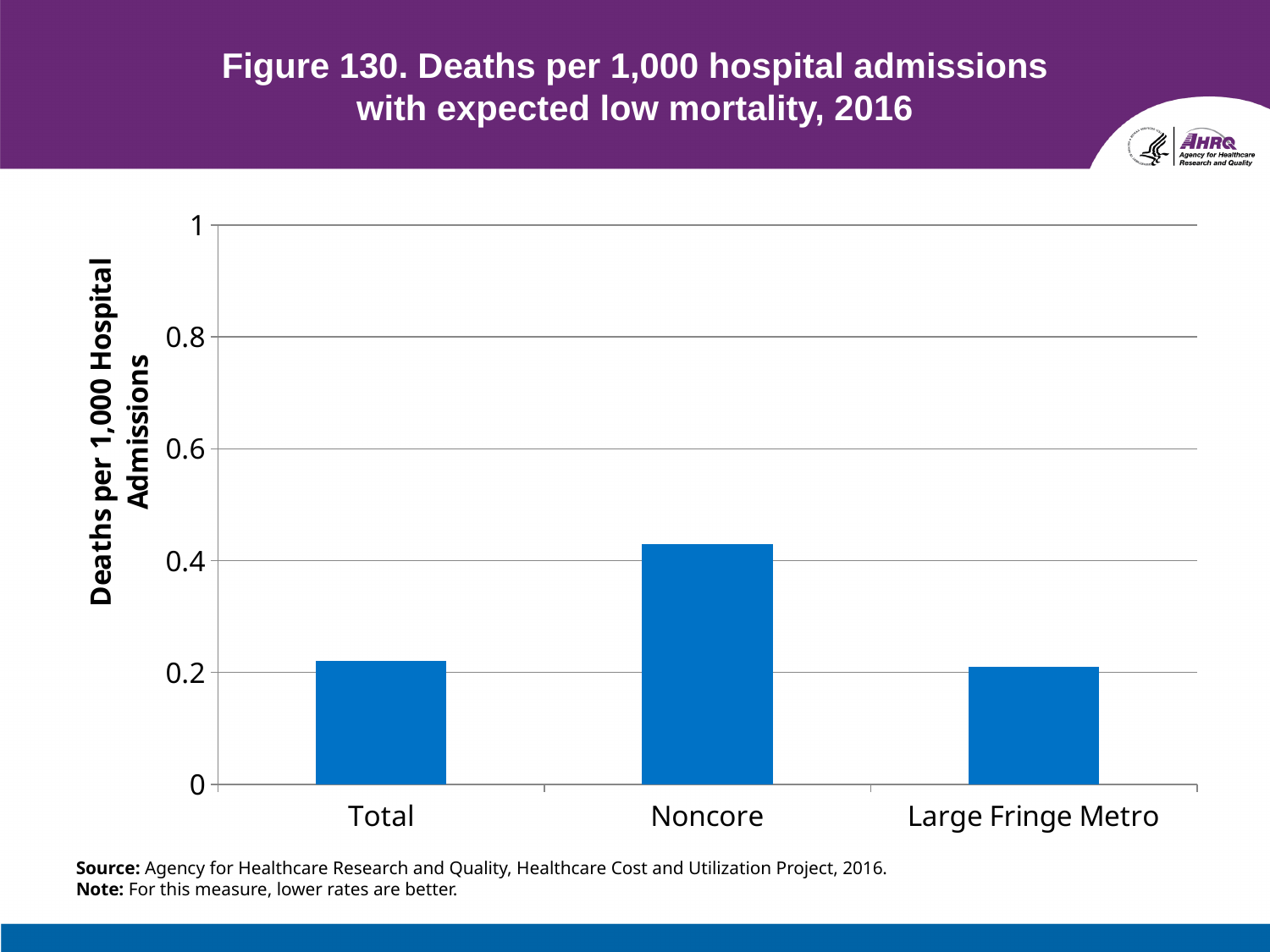
Is the value for Total greater or less than 0.4? less What is the highest value shown on the y axis of the chart? 1 Is the value for Noncore greater or less than 0.4? greater Which is larger, the value for Large Fringe Metro or the value for Noncore? Noncore What is the label on the y axis of the chart? Deaths per 1,000 Hospital Admissions Which category has the highest deaths per 1,000 hospital admissions? Noncore Is the value for Large Fringe Metro greater or less than 0.4? less Which is larger, the value for Noncore or the value for Total? Noncore How many categories are shown on the x axis of the chart? 3 What is the title of the chart on the slide? Figure 130. Deaths per 1,000 hospital admissions with expected low mortality, 2016 What kind of chart is shown on the slide? bar chart